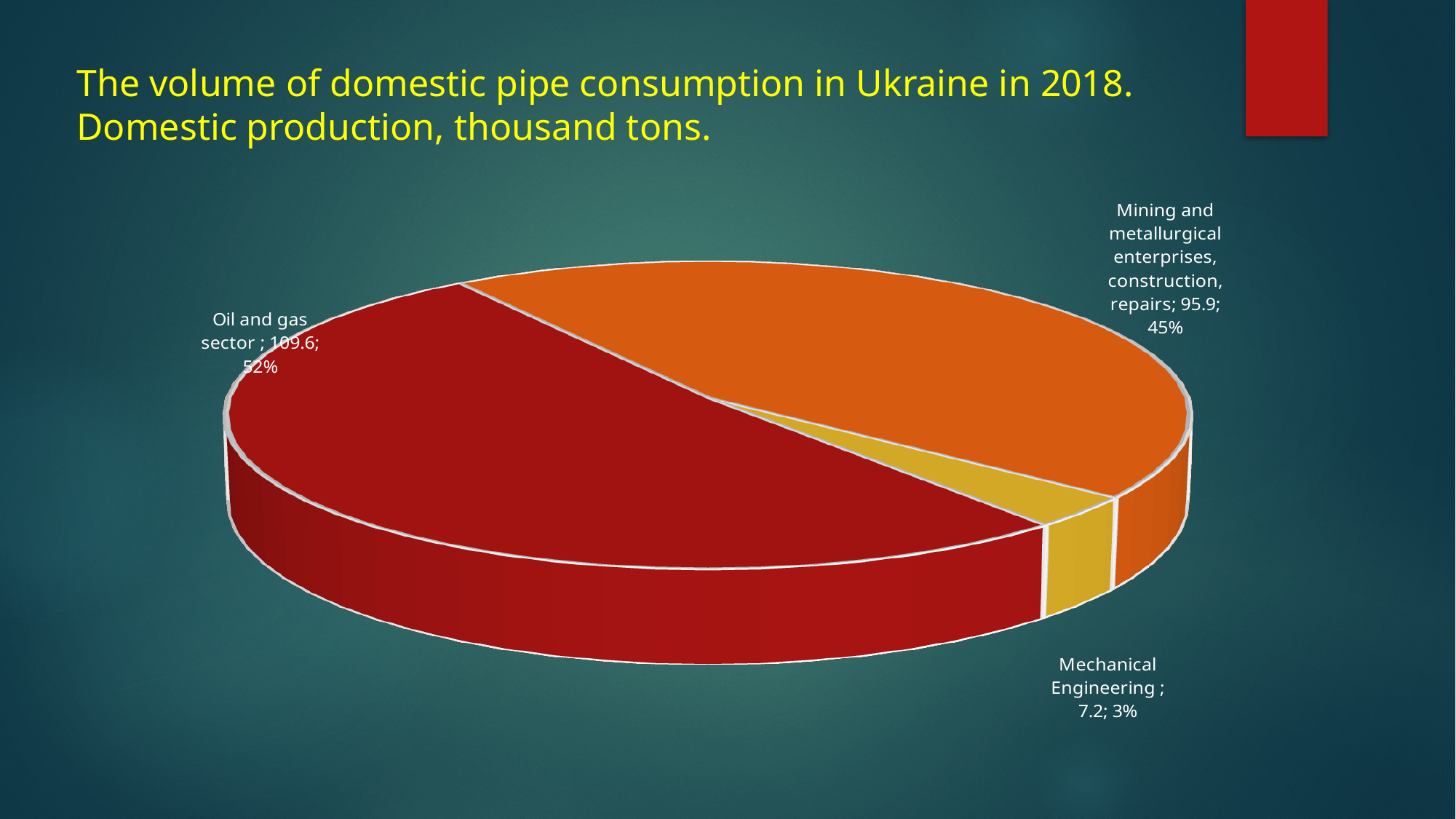
Which category has the smallest slice? Mechanical Engineering Which is larger: Mining and metallurgical enterprises, construction, repairs or Mechanical Engineering? Mining and metallurgical enterprises, construction, repairs What is the value for Mechanical Engineering? 7.2 What kind of chart is shown on the slide? Pie chart What share of the pie does Mechanical Engineering represent? 3% What is the title of the chart on the slide? The volume of domestic pipe consumption in Ukraine in 2018. Domestic production, thousand tons. What is the value for the Oil and gas sector? 109.6 What is the difference between the Oil and gas sector value and the Mining and metallurgical enterprises, construction, repairs value? 13.7 What is the value for Mining and metallurgical enterprises, construction, repairs? 95.9 How many slices does the pie chart have? 3 What share of the pie does the Oil and gas sector represent? 52% Which category has the largest slice? Oil and gas sector